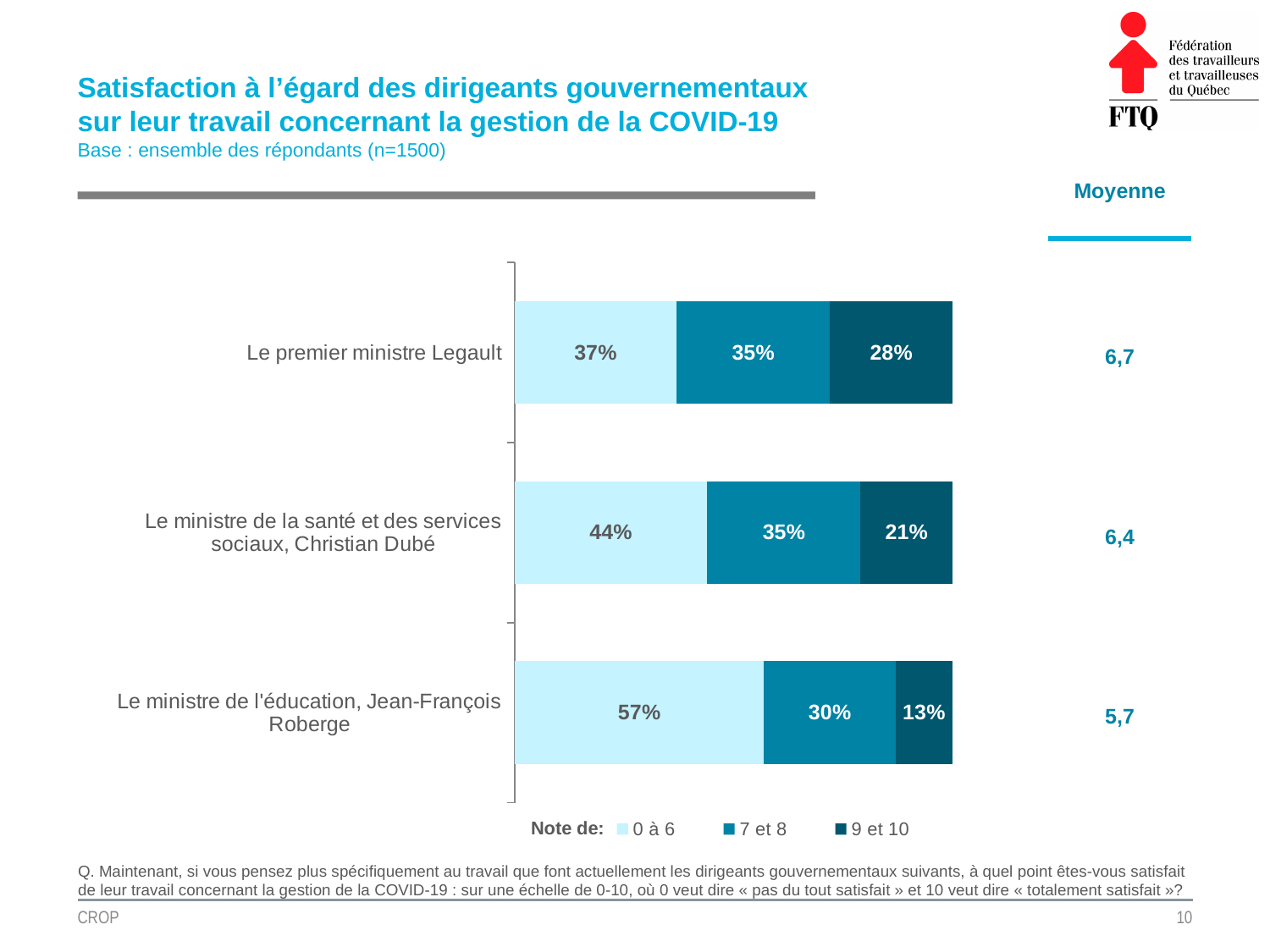
What are the three score ranges listed in the legend under 'Note de:'? 0 à 6, 7 et 8, 9 et 10 What is the total of the three segments for Le ministre de la santé et des services sociaux, Christian Dubé? 100% What is the Moyenne (average score) shown for Le ministre de la santé et des services sociaux, Christian Dubé? 6,4 How many government leaders are shown in the chart? 3 What percentage of respondents gave Le ministre de l'éducation, Jean-François Roberge a score of 9 et 10? 13% Which is larger: the 7 et 8 share for Le premier ministre Legault or the 7 et 8 share for Jean-François Roberge? Le premier ministre Legault Which government leader has the highest share of respondents giving a score of 0 à 6? Le ministre de l'éducation, Jean-François Roberge Which government leader has the lowest Moyenne? Le ministre de l'éducation, Jean-François Roberge What percentage of respondents gave Le premier ministre Legault a score of 0 à 6? 37% How many score categories does the legend list? 3 What kind of chart is shown on the slide? Stacked bar chart What is the difference in percentage points between the 9 et 10 share for Le premier ministre Legault and for Christian Dubé? 7